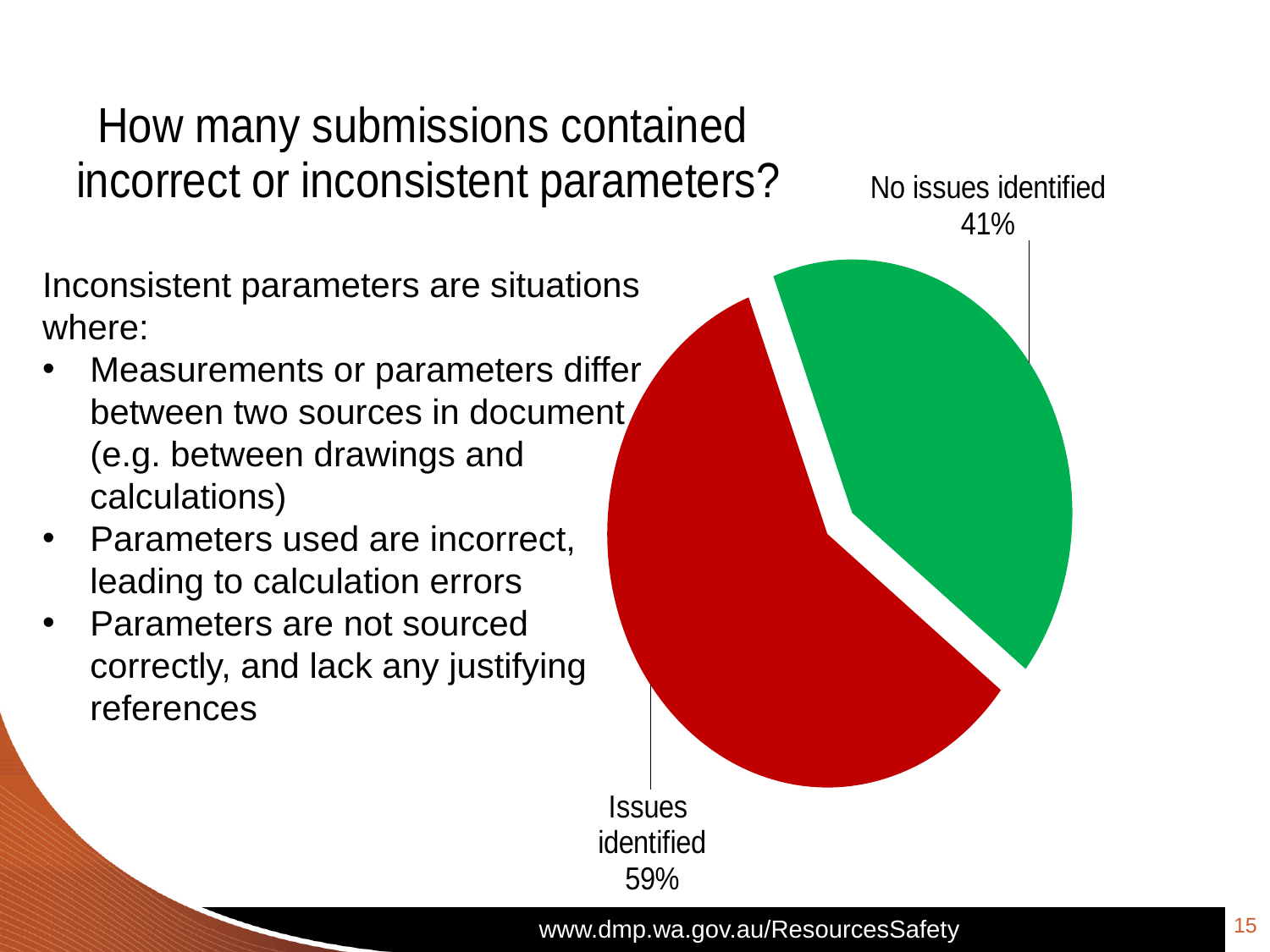
What share of the pie is labelled "Issues identified"? 59% What colour is the "Issues identified" slice? Red What colour is the "No issues identified" slice? Green How many slices does the pie chart have? 2 What kind of chart is shown on the slide? Pie chart Which is larger, the "Issues identified" slice or the "No issues identified" slice? Issues identified Which slice of the pie is the smallest? No issues identified What is the difference in percentage points between the "Issues identified" and "No issues identified" slices? 18 Is the share for "No issues identified" greater or less than 50%? less Which slice of the pie is the largest? Issues identified What do the two slices of the pie add up to? 100% What share of the pie is labelled "No issues identified"? 41%